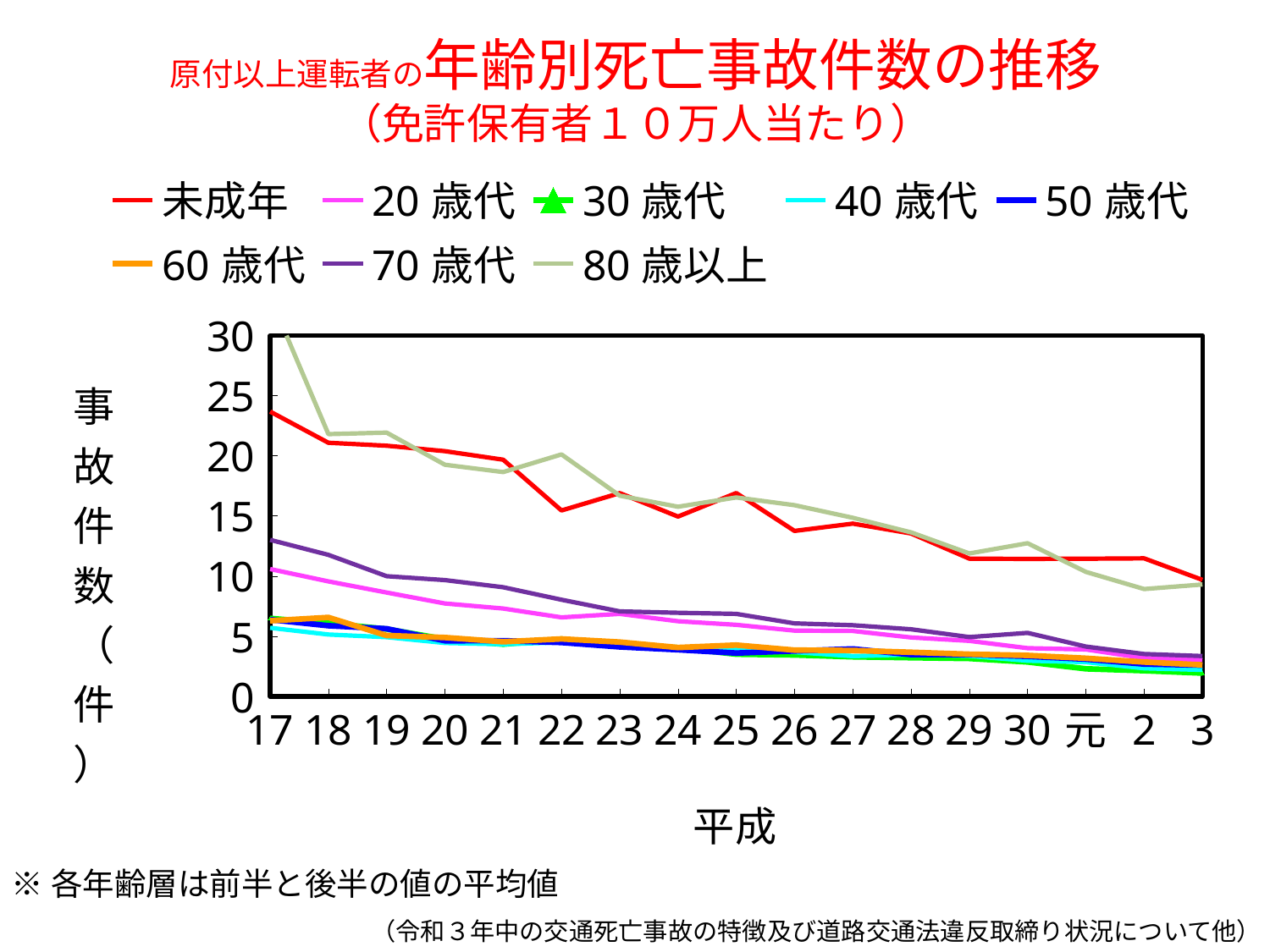
Is the value for 70歳代 at the last point (3) greater or less than 5? less How many points along the x axis does each line have? 17 Which series has the highest value at 平成17? 80歳以上 What is the label of the y axis? 事故件数（件） What kind of chart is shown on the slide? line chart Does the 未成年 line generally rise or fall from 平成17 to 3? fall Is the value for 70歳代 at 平成17 greater or less than 10? greater Which series has the highest value at the last point (3)? 未成年 Is the value for 80歳以上 at 平成17 greater or less than 25? greater At 平成17, which is larger, the value for 未成年 or the value for 70歳代? 未成年 How many series does the legend list? 8